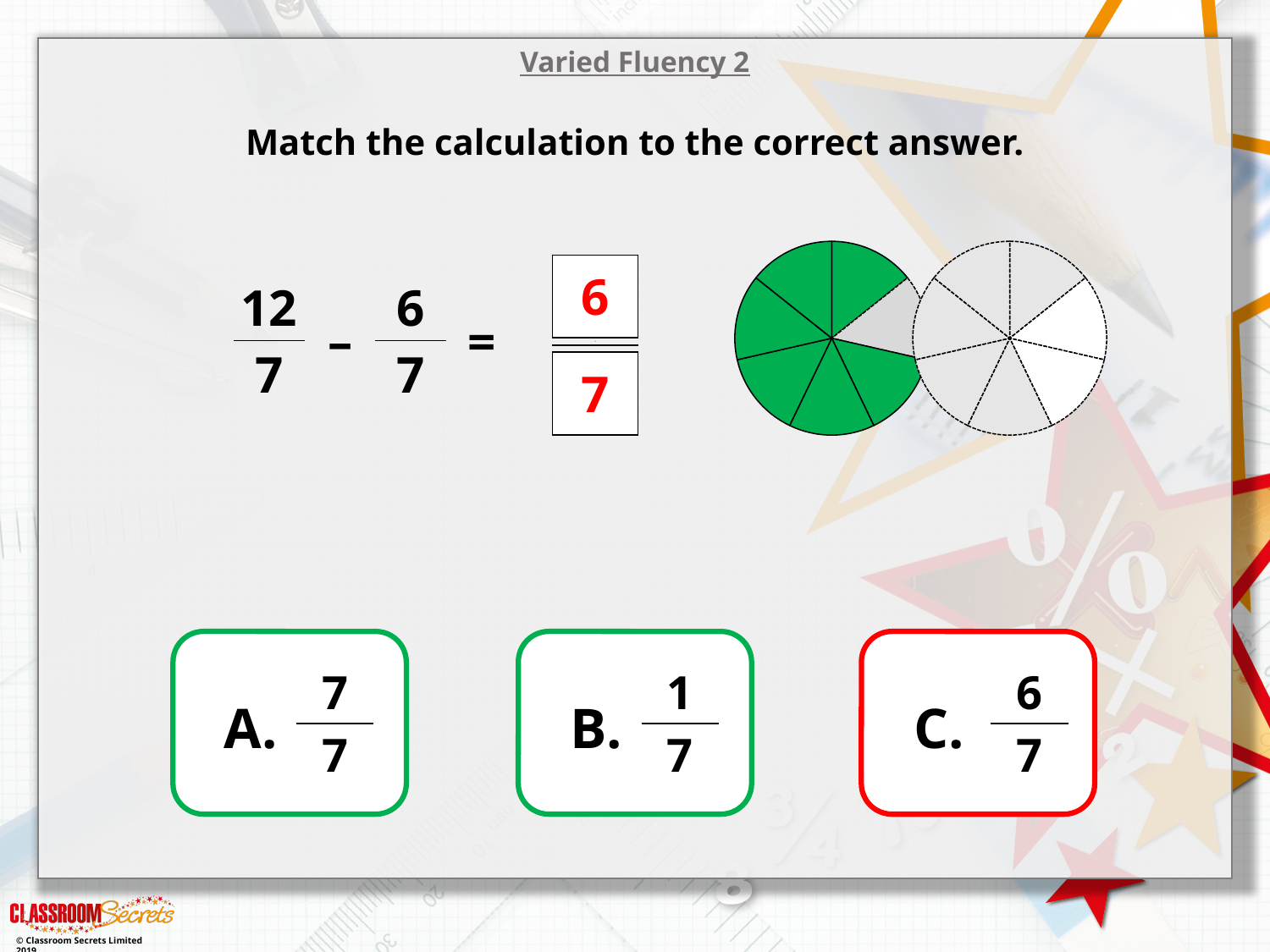
How many of the parts in the left circle are shaded green? 6 What fraction is shown in the answer boxes next to the calculation? 6/7 Which answer option (A, B or C) is outlined in red? C How many circle diagrams are shown on the slide? 2 What colour are most of the shaded parts in the left circle? green How many equal parts is the green circle divided into? 7